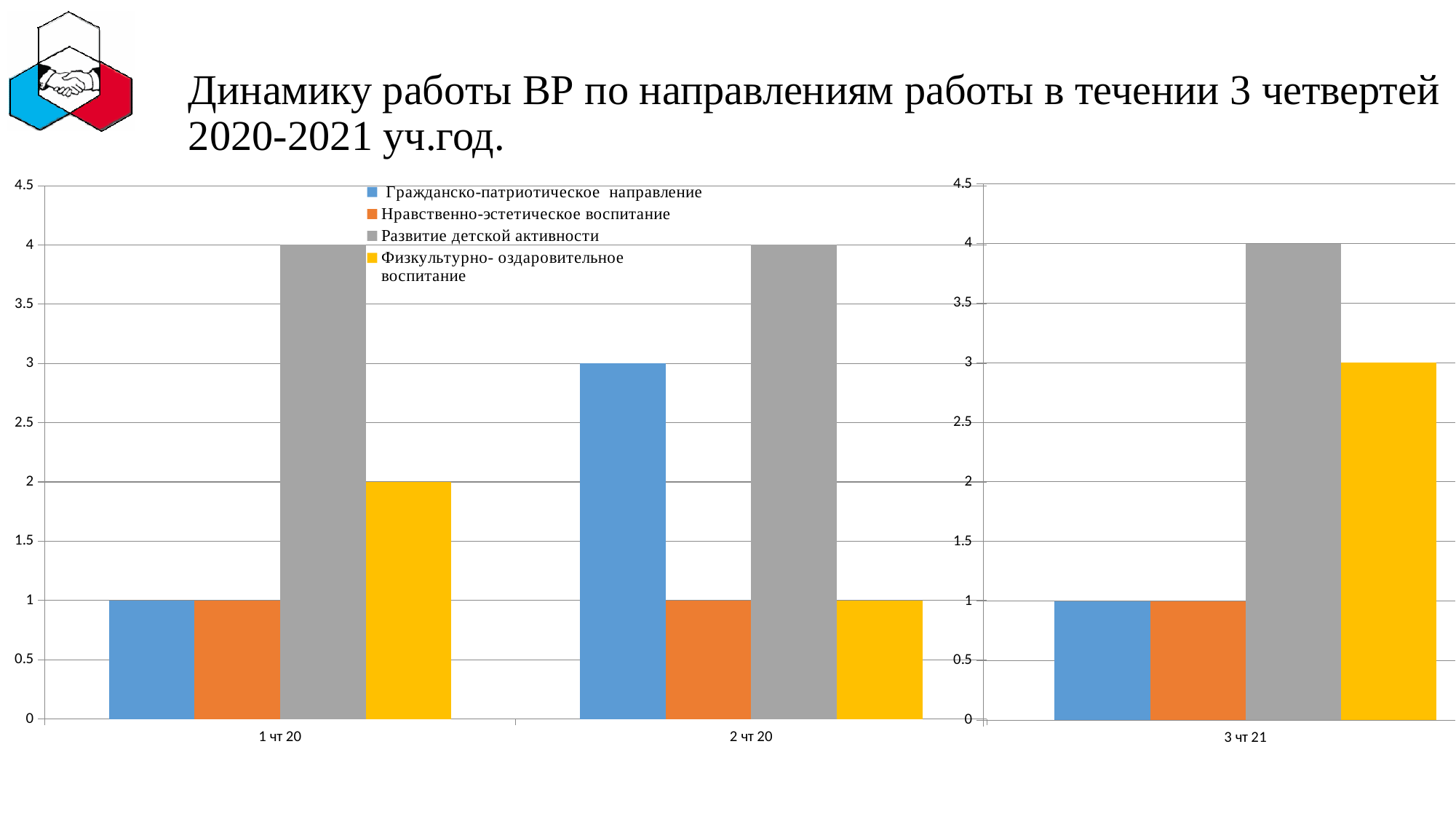
In the left chart, what is the value of Гражданско-патриотическое направление for 2 чт 20? 3 In the left chart, is the value of Гражданско-патриотическое направление larger for 1 чт 20 or for 2 чт 20? 2 чт 20 In the right chart, what is the value of Физкультурно- оздаровительное воспитание for 3 чт 21? 3 In the right chart, what is the difference between Развитие детской активности and Нравственно-эстетическое воспитание for 3 чт 21? 3 In the right chart, which series has the highest value for 3 чт 21? Развитие детской активности How many categories are shown on the x axis of the left chart? 2 In the left chart, what is the value of Развитие детской активности for 1 чт 20? 4 In the left chart, which series has the highest value for 2 чт 20? Развитие детской активности In the left chart, what is the difference between Развитие детской активности and Физкультурно- оздаровительное воспитание for 1 чт 20? 2 In the left chart, what is the value of Физкультурно- оздаровительное воспитание for 1 чт 20? 2 How many series does the legend on the left chart list? 4 What kind of chart is the left chart on the slide? bar chart